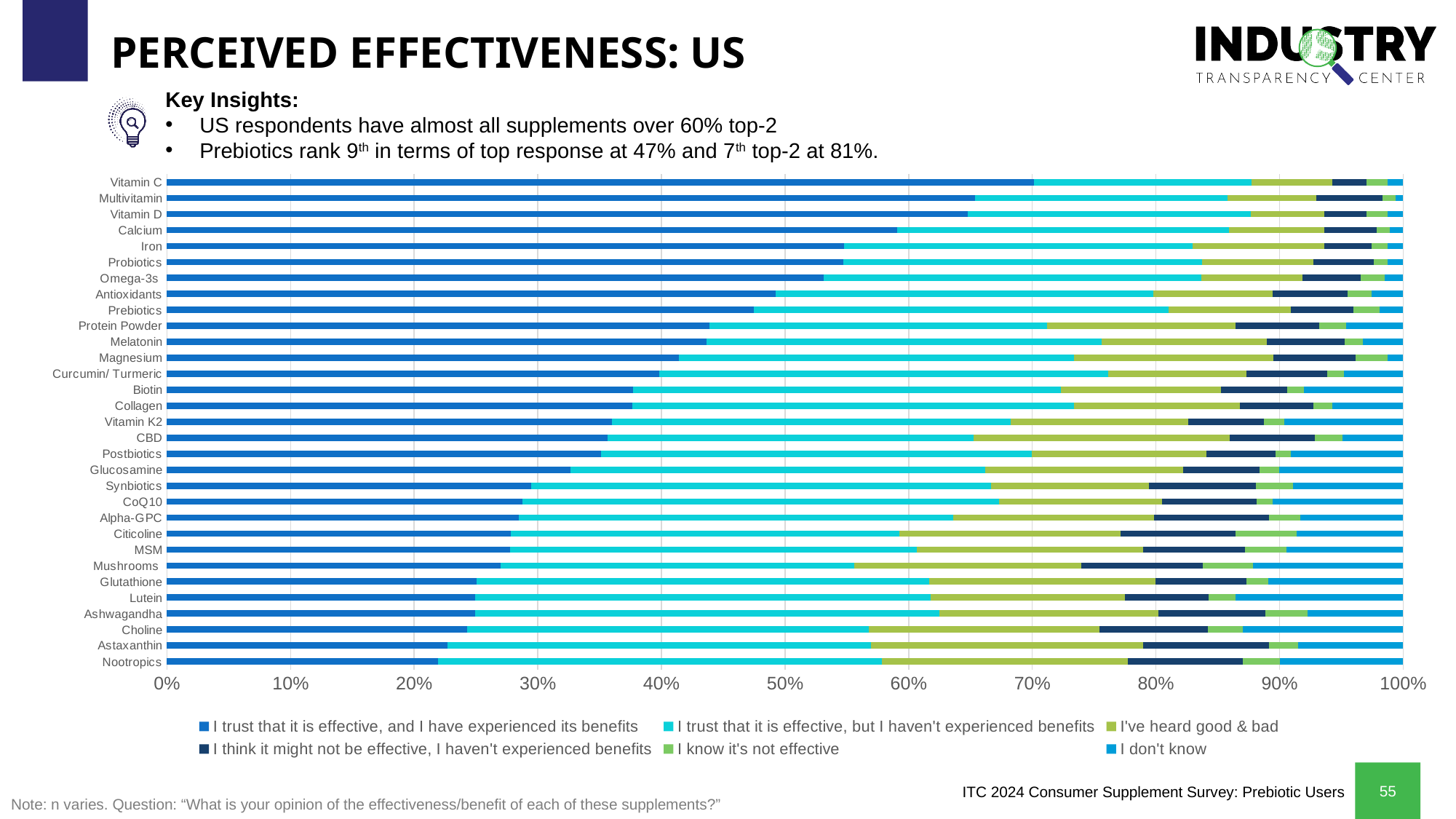
How many supplement categories are plotted on the chart? 31 What kind of chart is shown on the slide? Stacked bar chart Which supplement has the smallest share of respondents who trust it is effective and have experienced its benefits? Nootropics Is the 'I trust that it is effective, and I have experienced its benefits' share for Iron greater or less than 50%? greater How many series does the legend list? 6 Is the 'I trust that it is effective, and I have experienced its benefits' share for Multivitamin greater or less than 60%? greater What is the first legend entry of the chart? I trust that it is effective, and I have experienced its benefits Moving down the list from Vitamin C to Nootropics, does the 'I trust that it is effective, and I have experienced its benefits' share rise or fall? Fall Which has a larger 'I trust that it is effective, and I have experienced its benefits' share, Calcium or Iron? Calcium Which supplement has the largest share of respondents who trust it is effective and have experienced its benefits? Vitamin C According to the slide, what is the top-response percentage for Prebiotics? 47% Is the 'I trust that it is effective, and I have experienced its benefits' share for Nootropics greater or less than 30%? less